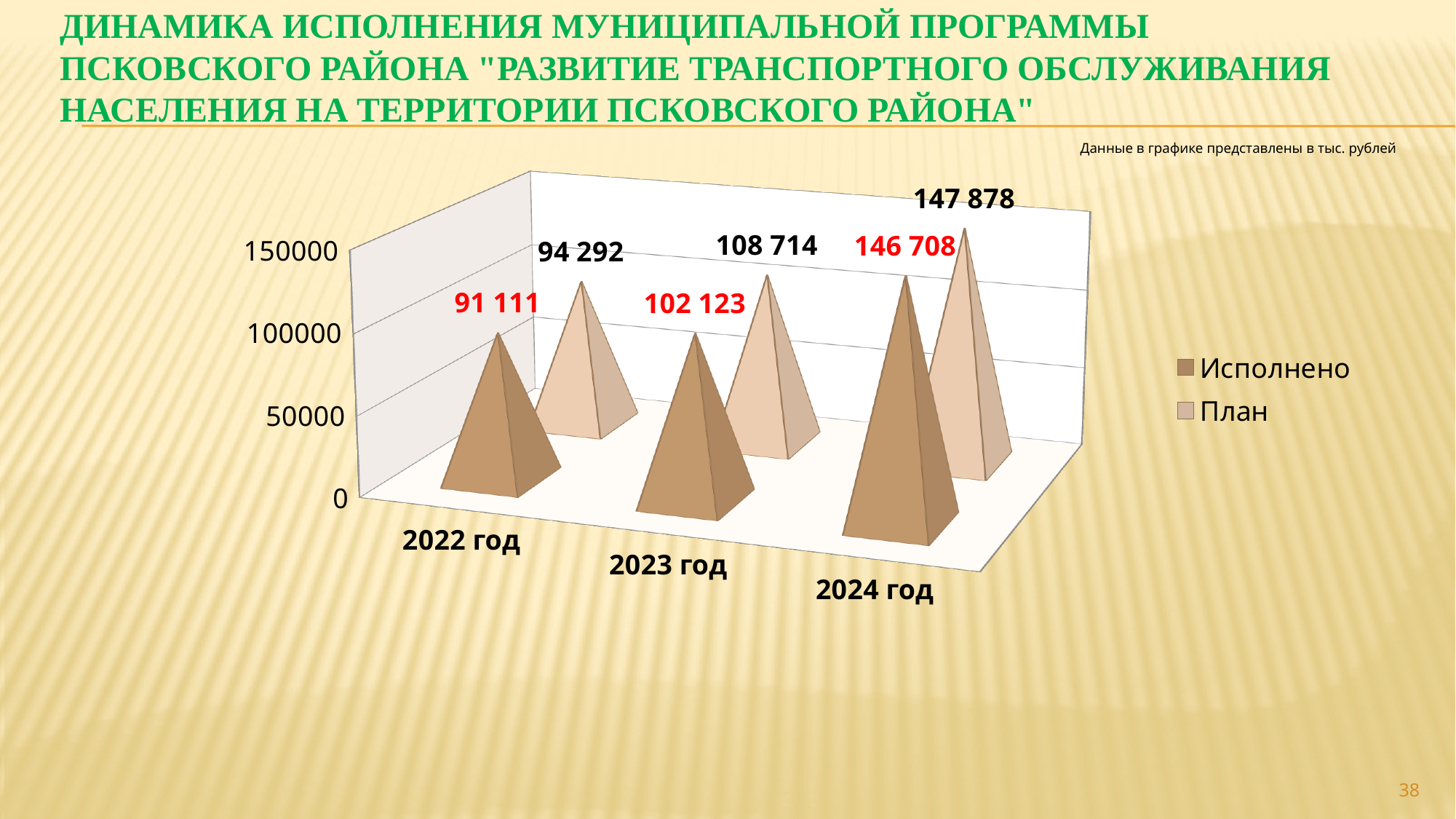
What is the value of Исполнено for 2024 год? 146 708 What is the difference between План and Исполнено for 2023 год? 6 591 How many years are shown on the x axis? 3 In which year is the План value the lowest? 2022 год In which year is the Исполнено value the highest? 2024 год What is the value of Исполнено for 2022 год? 91 111 Do the Исполнено values rise or fall from 2022 год to 2024 год? rise What is the value of План for 2023 год? 108 714 By how much did Исполнено increase from 2022 год to 2024 год? 55 597 How many series does the legend list? 2 What is the value of План for 2024 год? 147 878 Which is larger for 2022 год: План or Исполнено? План